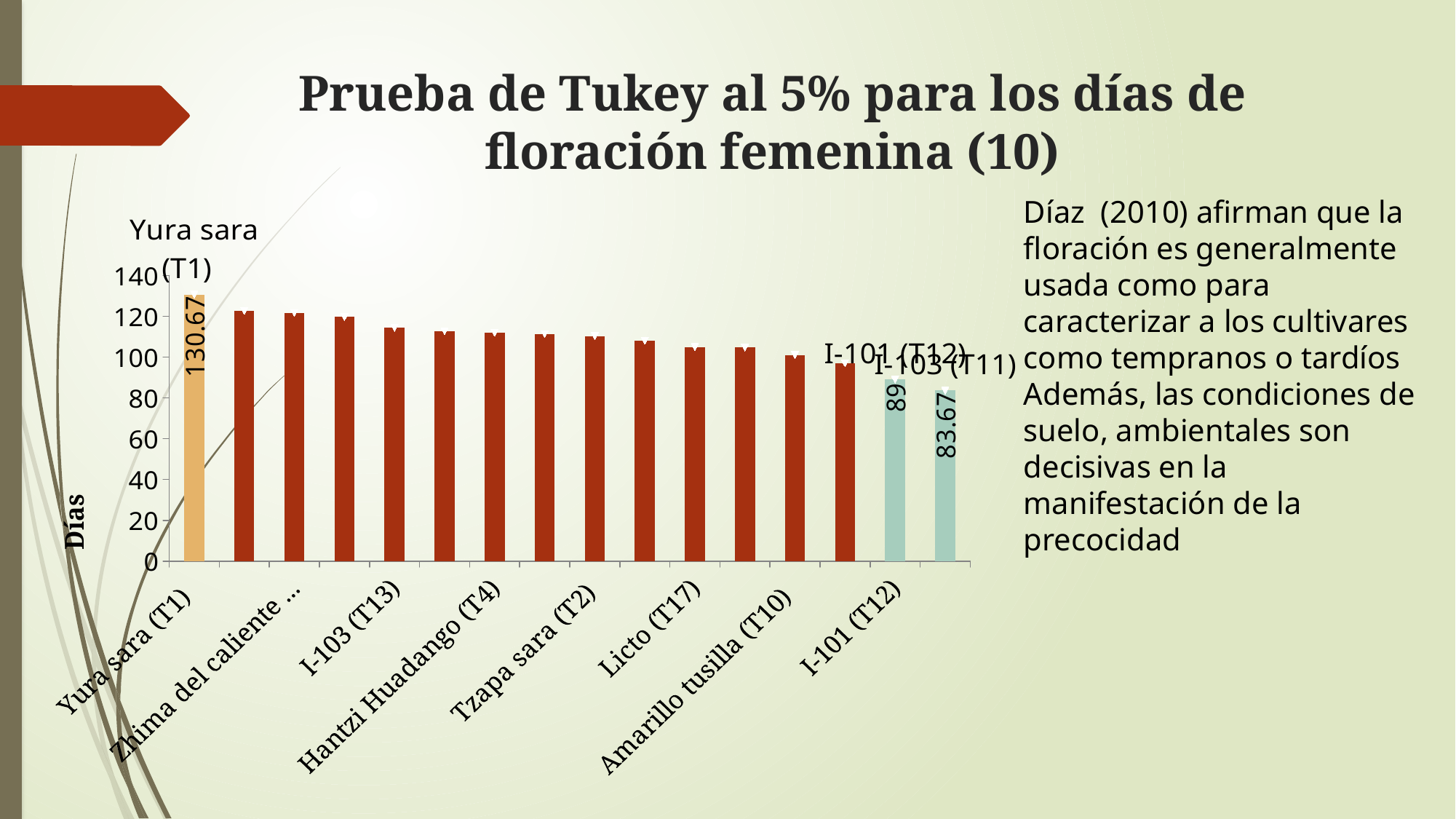
What kind of chart is shown on the slide? bar chart Which is larger, the value for I-101 (T12) or the value for I-103 (T11)? I-101 (T12) What is the difference between the values for Yura sara (T1) and I-103 (T11)? 47 Is the value for Hantzi Huadango (T4) greater or less than 100? greater Which category has the highest value? Yura sara (T1) What is the difference between the values for I-101 (T12) and I-103 (T11)? 5.33 What is the value for I-101 (T12)? 89 Which category has the lowest value? I-103 (T11) Do the values rise or fall from left to right along the x axis? fall Is the value for Tzapa sara (T2) greater or less than 120? less What is the value for Yura sara (T1)? 130.67 What is the value for I-103 (T11)? 83.67